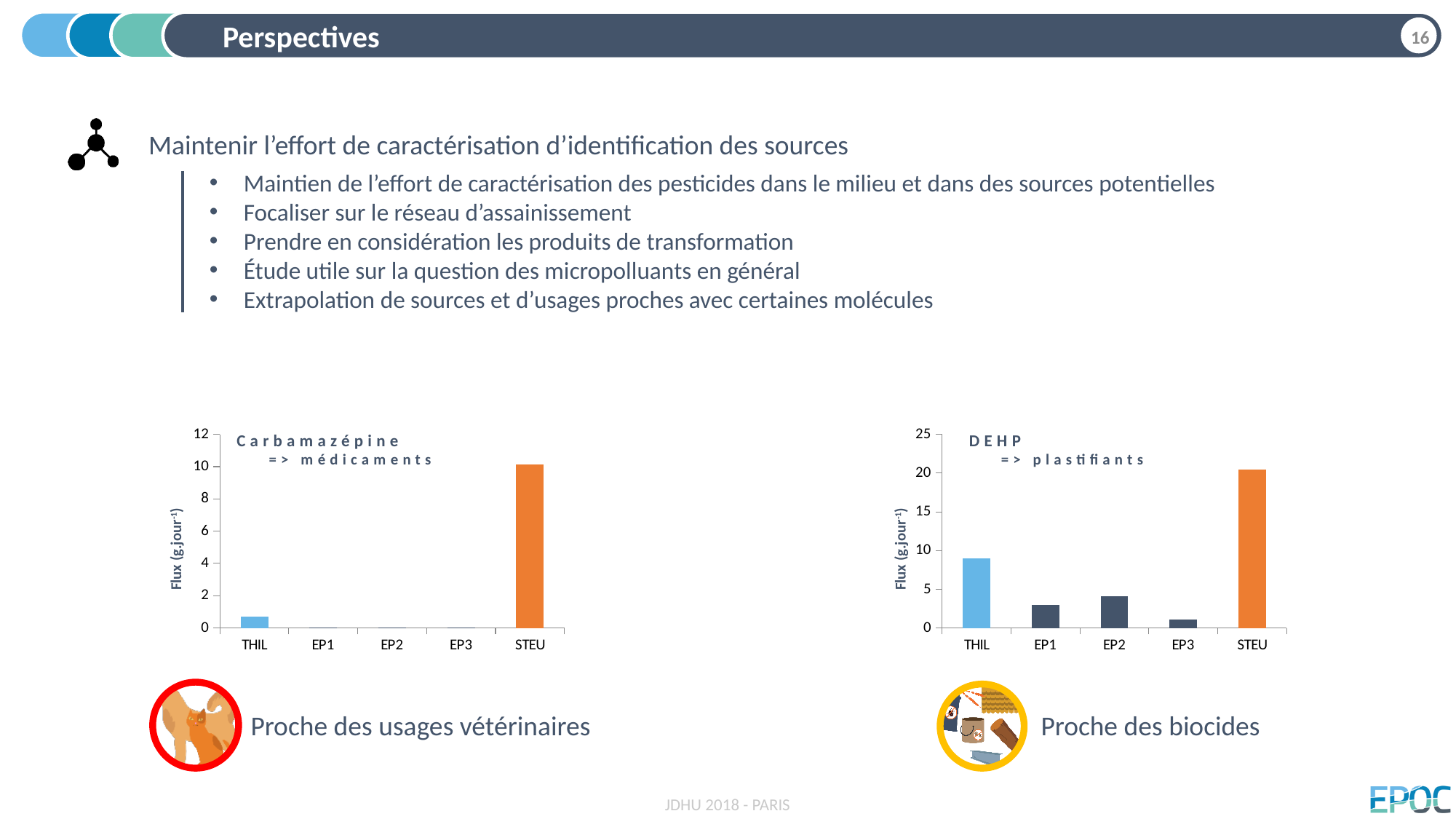
In the DEHP chart, which category has the highest value? STEU In the DEHP chart, is the value for THIL greater or less than 10? less In the DEHP chart, which is larger, the value for THIL or the value for EP3? THIL In the DEHP chart, how many categories are shown on the x axis? 5 In the Carbamazépine chart, is the value for THIL greater or less than 2? less In the DEHP chart, which category has the lowest value? EP3 What is the y-axis label of the Carbamazépine chart? Flux (g.jour-1) In the DEHP chart, which is larger, the value for EP2 or the value for EP1? EP2 In the Carbamazépine chart, which category has the highest value? STEU In the Carbamazépine chart, what kind of chart is shown? bar chart